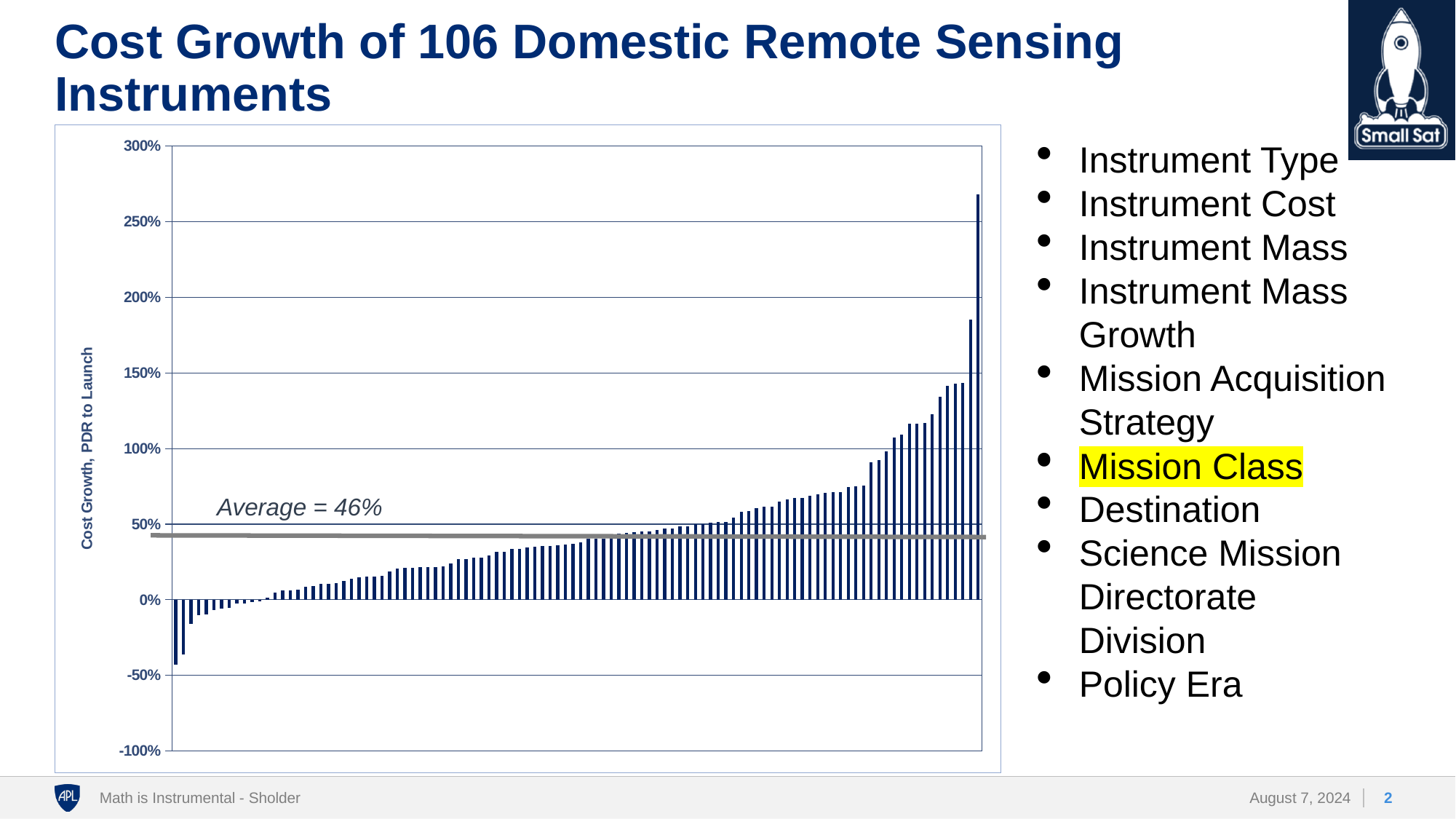
What is the average cost growth stated on the chart? 46% What is the label of the vertical axis of the chart? Cost Growth, PDR to Launch Is the value of the tallest bar greater or less than 250%? greater Is the value of the leftmost (lowest) bar greater or less than -50%? greater What kind of chart is shown on the slide? bar chart Do the bar values rise or fall from left to right along the x axis? rise Is the value of the second tallest bar greater or less than 200%? less How many instruments does the chart represent, according to the slide title? 106 What is the highest tick value shown on the vertical axis? 300%